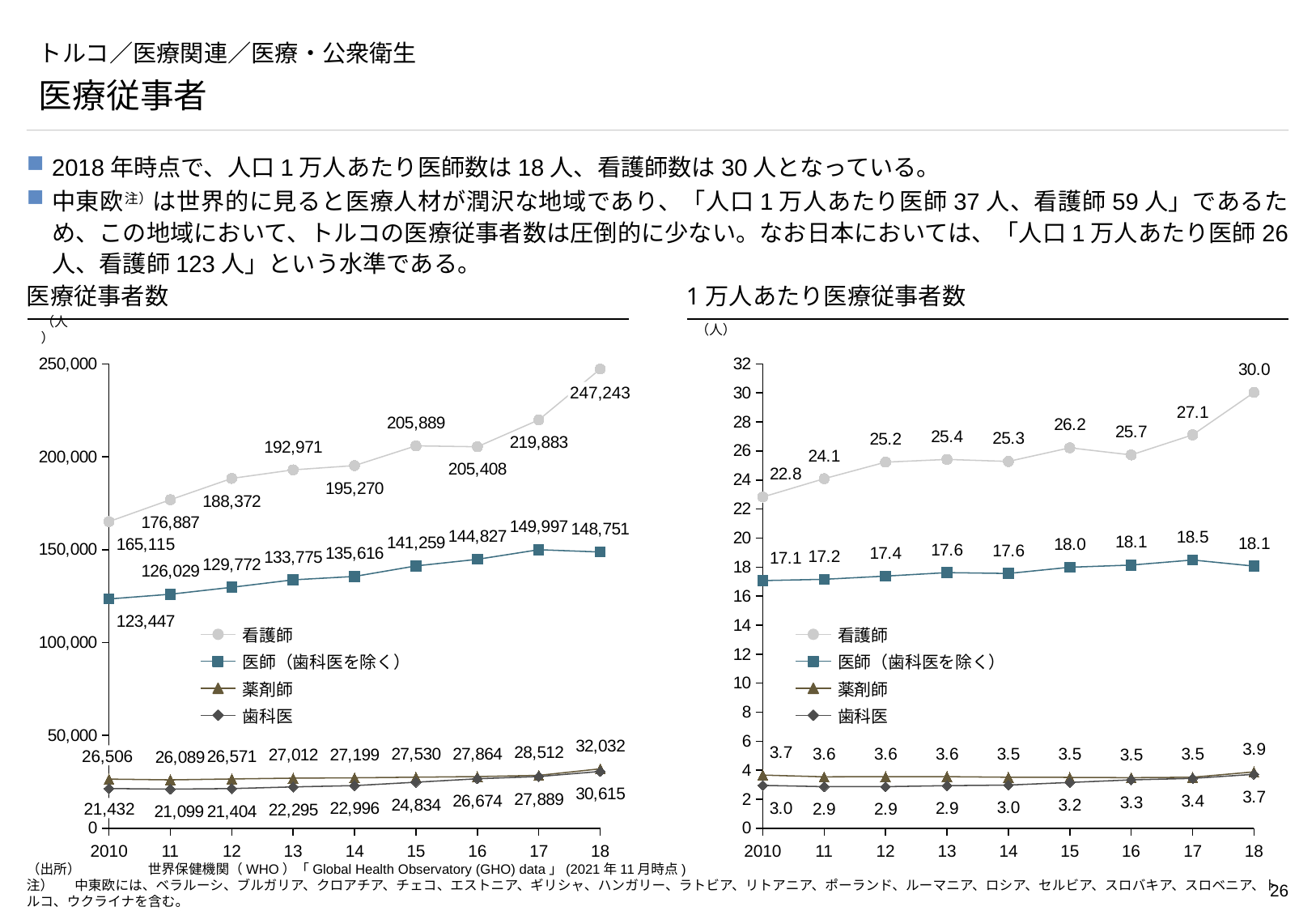
「医療従事者数」のグラフで、2010年の医師（歯科医を除く）の値はいくつですか？ 123,447 「医療従事者数」のグラフで、2018年の看護師と医師（歯科医を除く）の差はいくつですか？ 98,492 「1万人あたり医療従事者数」のグラフはどの種類のグラフですか？ 折れ線グラフ 「医療従事者数」のグラフで、医師（歯科医を除く）の値が最も高いのは何年ですか？ 2017 「医療従事者数」のグラフで、2018年の歯科医の値はいくつですか？ 30,615 「1万人あたり医療従事者数」のグラフで、看護師の値が最も低いのは何年ですか？ 2010 「1万人あたり医療従事者数」のグラフで、2018年の薬剤師と歯科医ではどちらの値が大きいですか？ 薬剤師 「医療従事者数」のグラフで、2018年の看護師の値はいくつですか？ 247,243 「1万人あたり医療従事者数」のグラフで、2018年の看護師の値はいくつですか？ 30.0 「1万人あたり医療従事者数」のグラフで、2010年の歯科医の値はいくつですか？ 3.0 「1万人あたり医療従事者数」のグラフで、2010年から2018年にかけて看護師の値は上昇していますか、下降していますか？ 上昇 「医療従事者数」のグラフの凡例には、いくつの系列がありますか？ 4